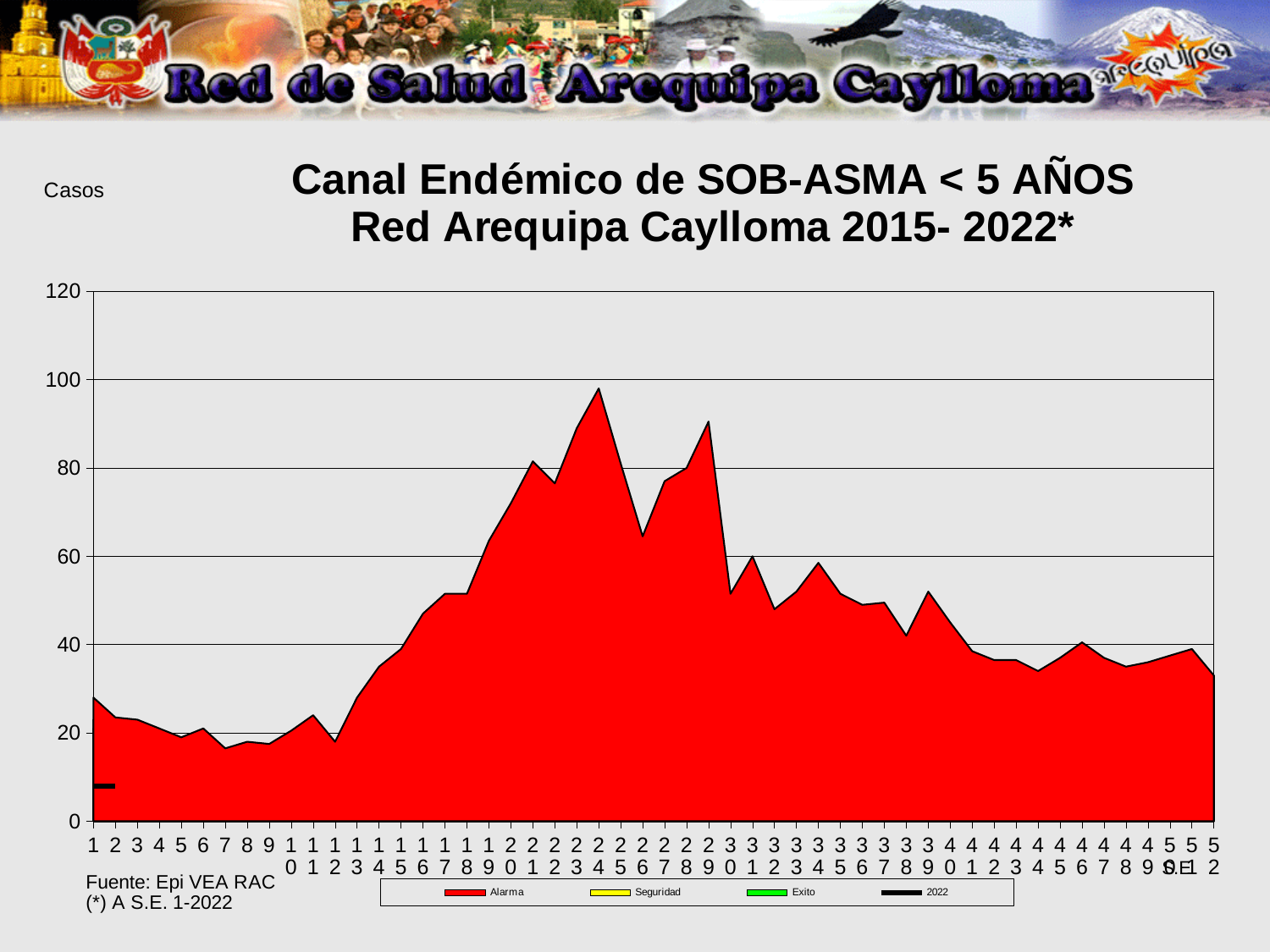
What kind of chart is shown on the slide? area chart How many epidemiological weeks are shown along the x axis? 52 Which week has the larger Alarma value, week 24 or week 29? week 24 Is the Alarma value at week 29 greater or less than 80? greater What label is shown on the y axis of the chart? Casos At which week does the Alarma area reach its highest value? 24 Is the Alarma value at week 1 greater or less than 40? less What is the title of the chart? Canal Endémico de SOB-ASMA < 5 AÑOS Red Arequipa Caylloma 2015- 2022* Do the Alarma values generally rise or fall from week 12 to week 24? rise How many series does the legend list? 4 Is the Alarma value at week 24 greater or less than 80? greater